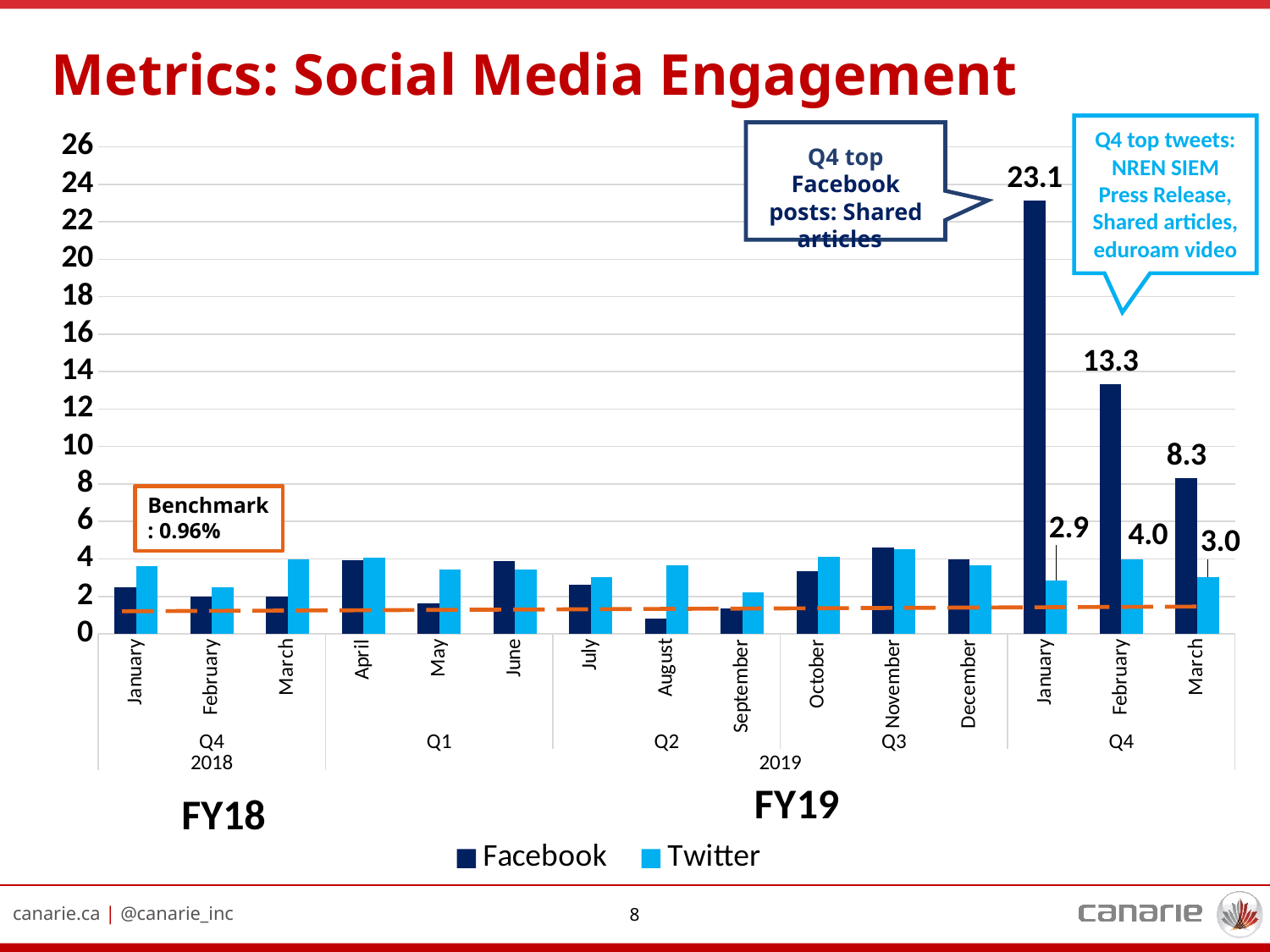
Is the Facebook value for August 2019 greater or less than 2? less What benchmark value is shown on the chart? 0.96% What is the Facebook value for January 2019 (Q4 FY19)? 23.1 How many series does the legend list? 2 What is the Facebook value for March 2019 (Q4 FY19)? 8.3 Which month has the highest Facebook value? January 2019 What kind of chart is shown on the slide? bar chart In March 2019 (Q4 FY19), which is larger, the Facebook value or the Twitter value? Facebook What is the Twitter value for January 2019 (Q4 FY19)? 2.9 What is the difference between the Facebook and Twitter values in January 2019 (Q4 FY19)? 20.2 What is the Twitter value for February 2019 (Q4 FY19)? 4.0 What is the difference between the Facebook values for February 2019 and March 2019? 5.0